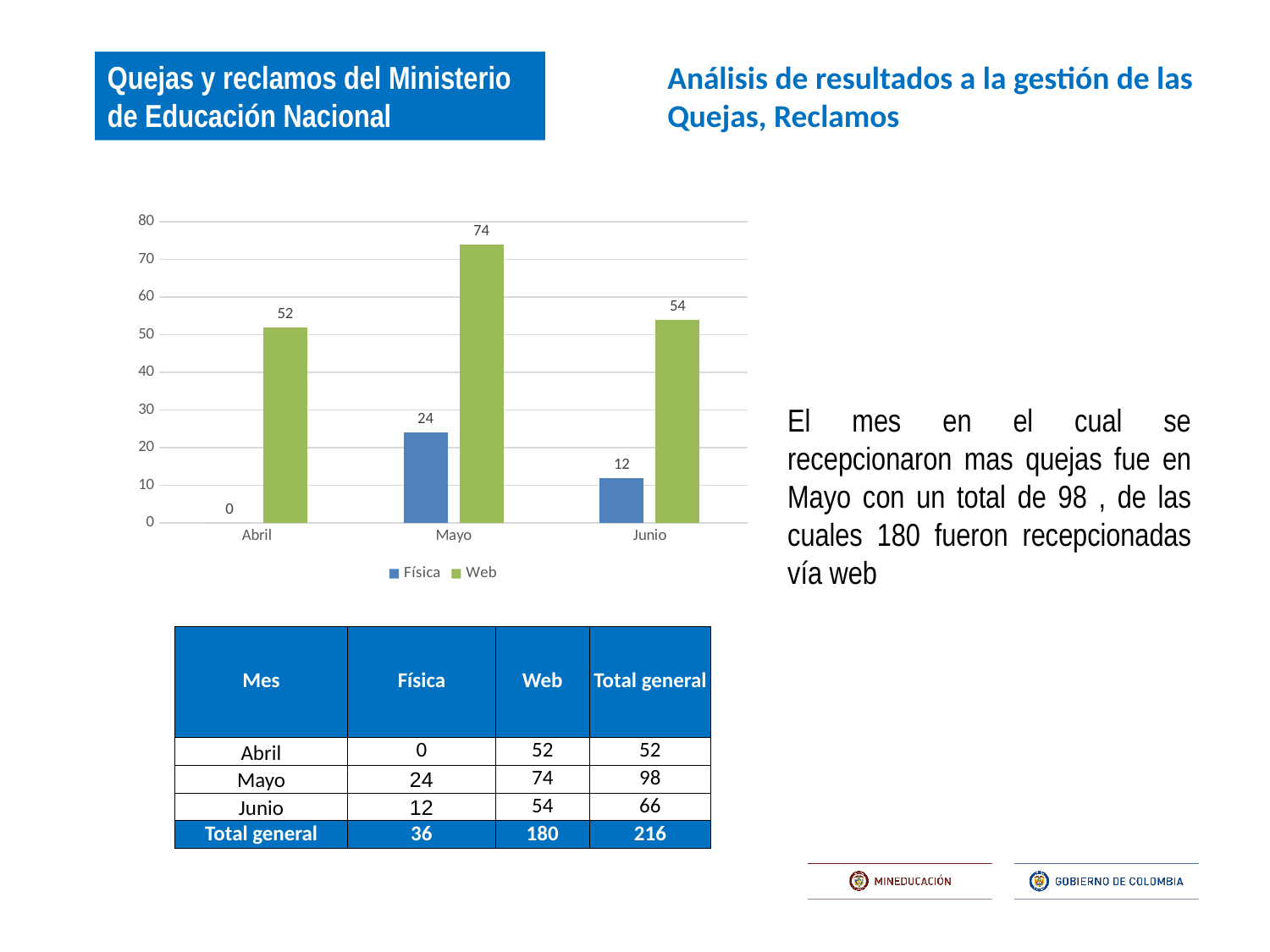
What is the combined Física and Web value for Junio? 66 Which colour represents the Web series in the legend? green Which month has the lowest Física value? Abril What is the Física value for Junio? 12 What is the Web value for Mayo? 74 Which month has the highest Web value? Mayo How many series does the legend list? 2 Which is larger, the Física value for Mayo or the Física value for Junio? Mayo What is the Física value for Abril? 0 How many months are shown on the x axis? 3 What is the difference between the Web values for Mayo and Junio? 20 What kind of chart is shown? bar chart